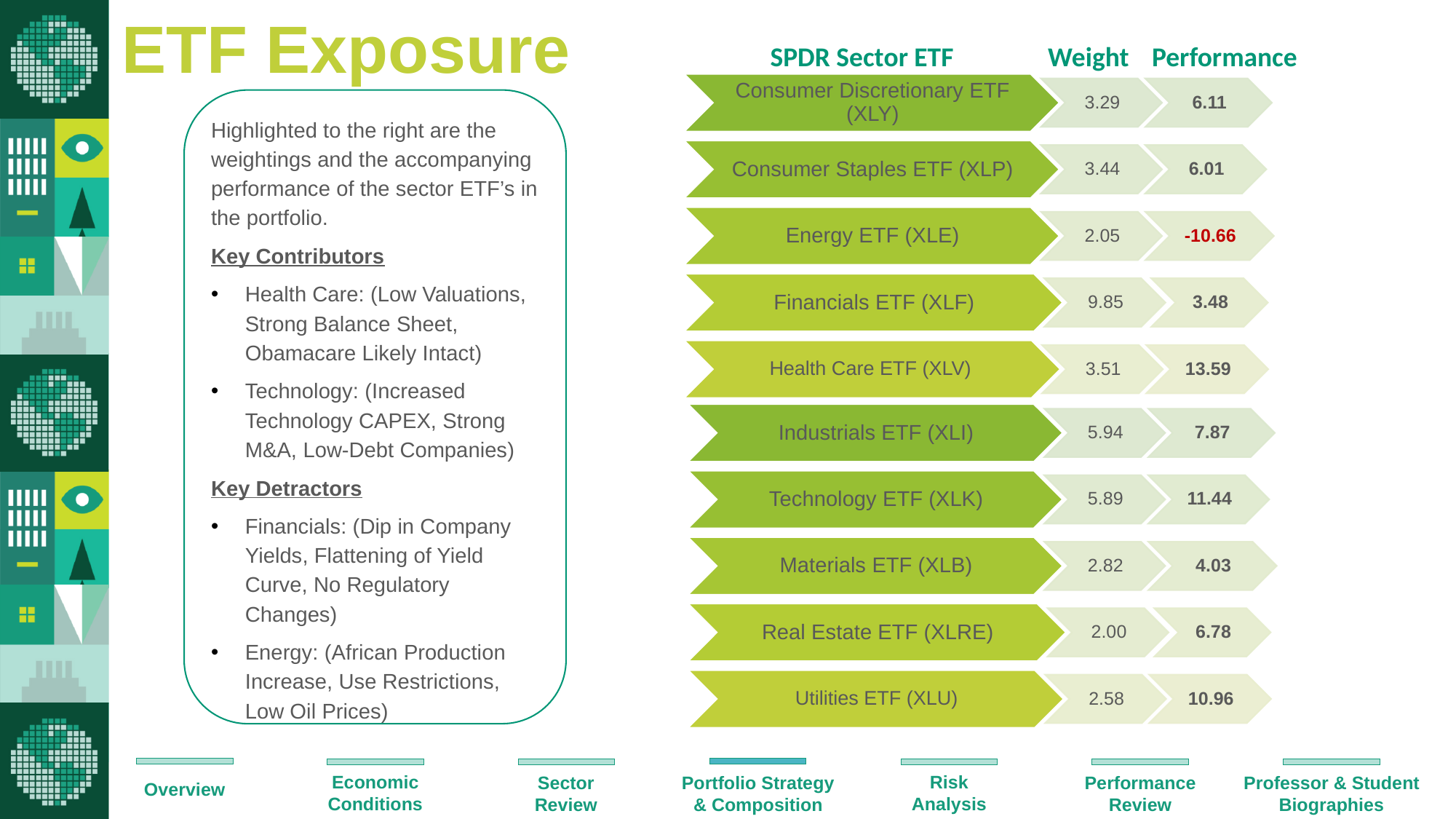
Which sector ETF has the smallest weight? Real Estate ETF (XLRE) What is the performance of the Health Care ETF (XLV)? 13.59 Which sector ETF has the highest performance? Health Care ETF (XLV) How many sector ETFs are listed in the table? 10 What is the weight of the Real Estate ETF (XLRE)? 2.00 What is the weight of the Financials ETF (XLF)? 9.85 What is the performance of the Energy ETF (XLE)? -10.66 Which has the higher performance, the Industrials ETF (XLI) or the Materials ETF (XLB)? Industrials ETF (XLI) Which sector ETF has the lowest performance? Energy ETF (XLE) What is the difference in performance between the Technology ETF (XLK) and the Utilities ETF (XLU)? 0.48 What are the three column headings of the table? SPDR Sector ETF, Weight, Performance Which sector ETF has the largest weight? Financials ETF (XLF)